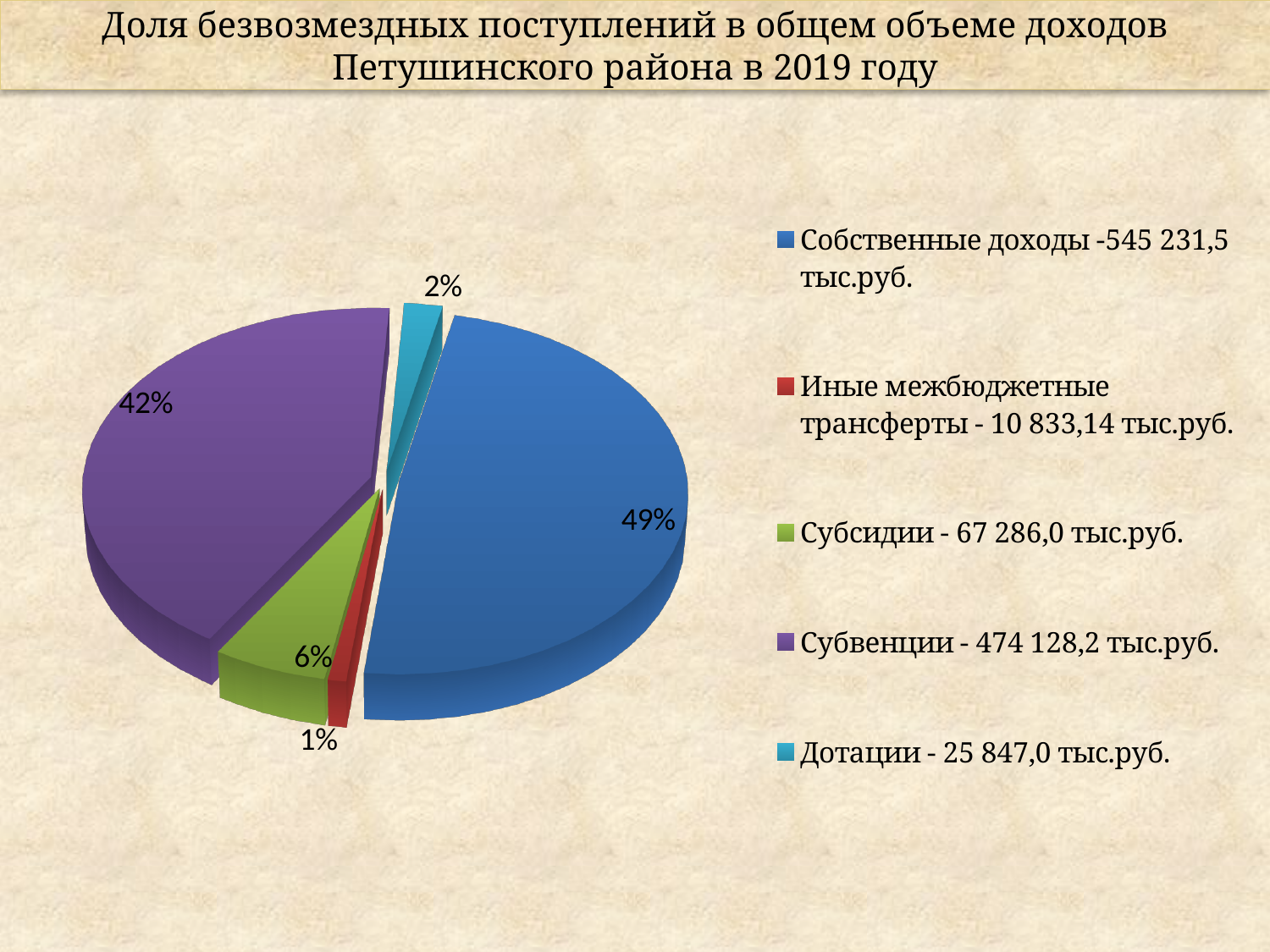
What share of the pie does Собственные доходы take? 49% What share of the pie does Иные межбюджетные трансферты take? 1% What kind of chart is shown on the slide? pie chart Which is larger: the share for Субсидии or the share for Дотации? Субсидии Which category has the smallest share of the pie? Иные межбюджетные трансферты What share of the pie does Субвенции take? 42% According to the legend, what amount in тыс.руб. is given for Субвенции? 474 128,2 тыс.руб. How many slices does the pie chart have? 5 What is the difference in percentage points between the shares of Собственные доходы and Субвенции? 7% Which category has the largest share of the pie? Собственные доходы